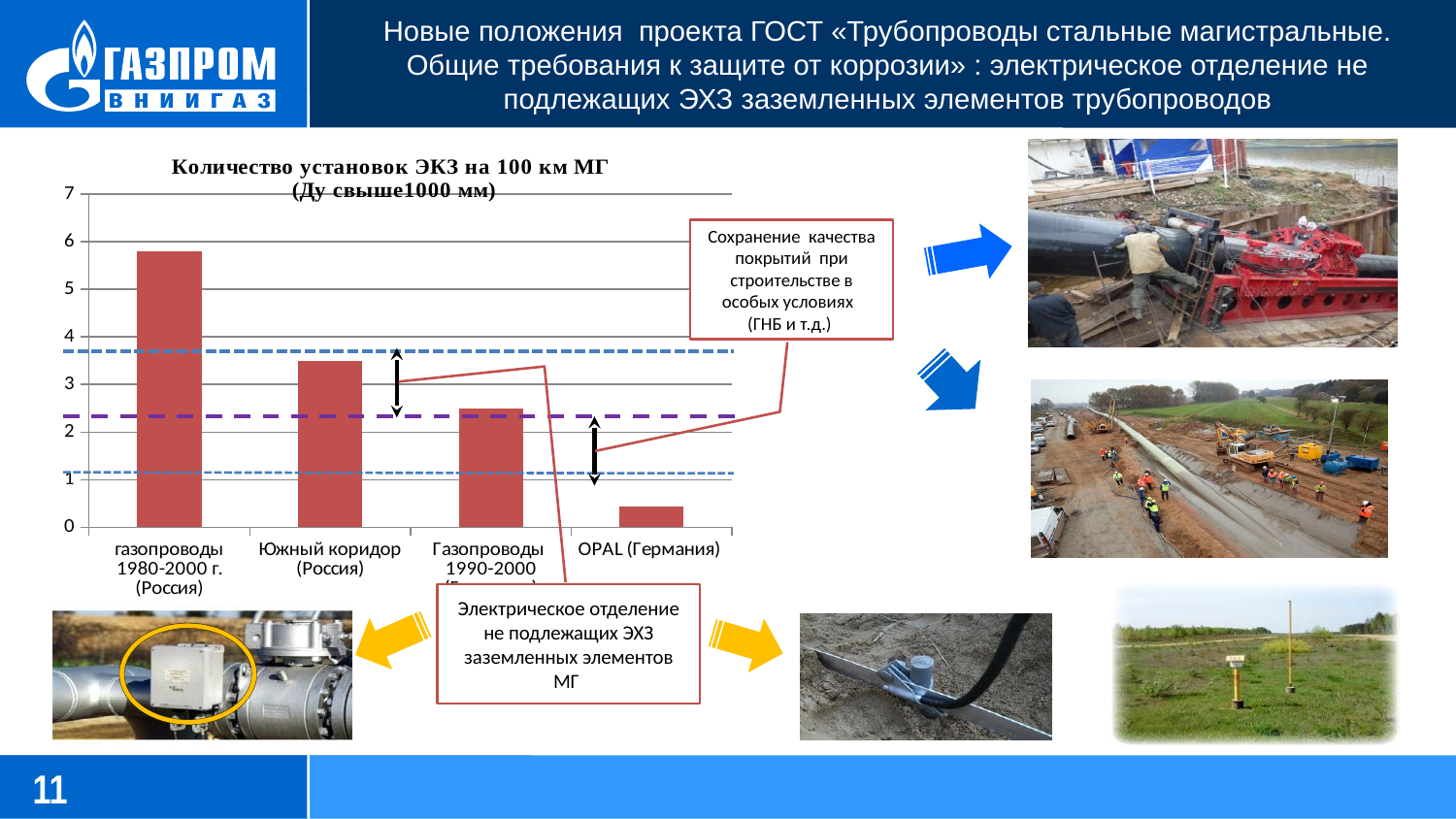
Which category has the lowest value in the chart? OPAL (Германия) Do the bar values rise or fall from left to right across the categories? fall Is the value for Газопроводы 1990-2000 greater or less than 3? less Which is larger: the value for Южный коридор (Россия) or the value for OPAL (Германия)? Южный коридор (Россия) Is the value for Южный коридор (Россия) greater or less than 3? greater How many categories are plotted in the chart? 4 What is the maximum value shown on the vertical axis of the chart? 7 Is the value for газопроводы 1980-2000 г. (Россия) greater or less than 5? greater What kind of chart is shown on the slide? bar chart What is the title of the chart? Количество установок ЭКЗ на 100 км МГ (Ду свыше1000 мм) Which category has the highest value in the chart? газопроводы 1980-2000 г. (Россия)